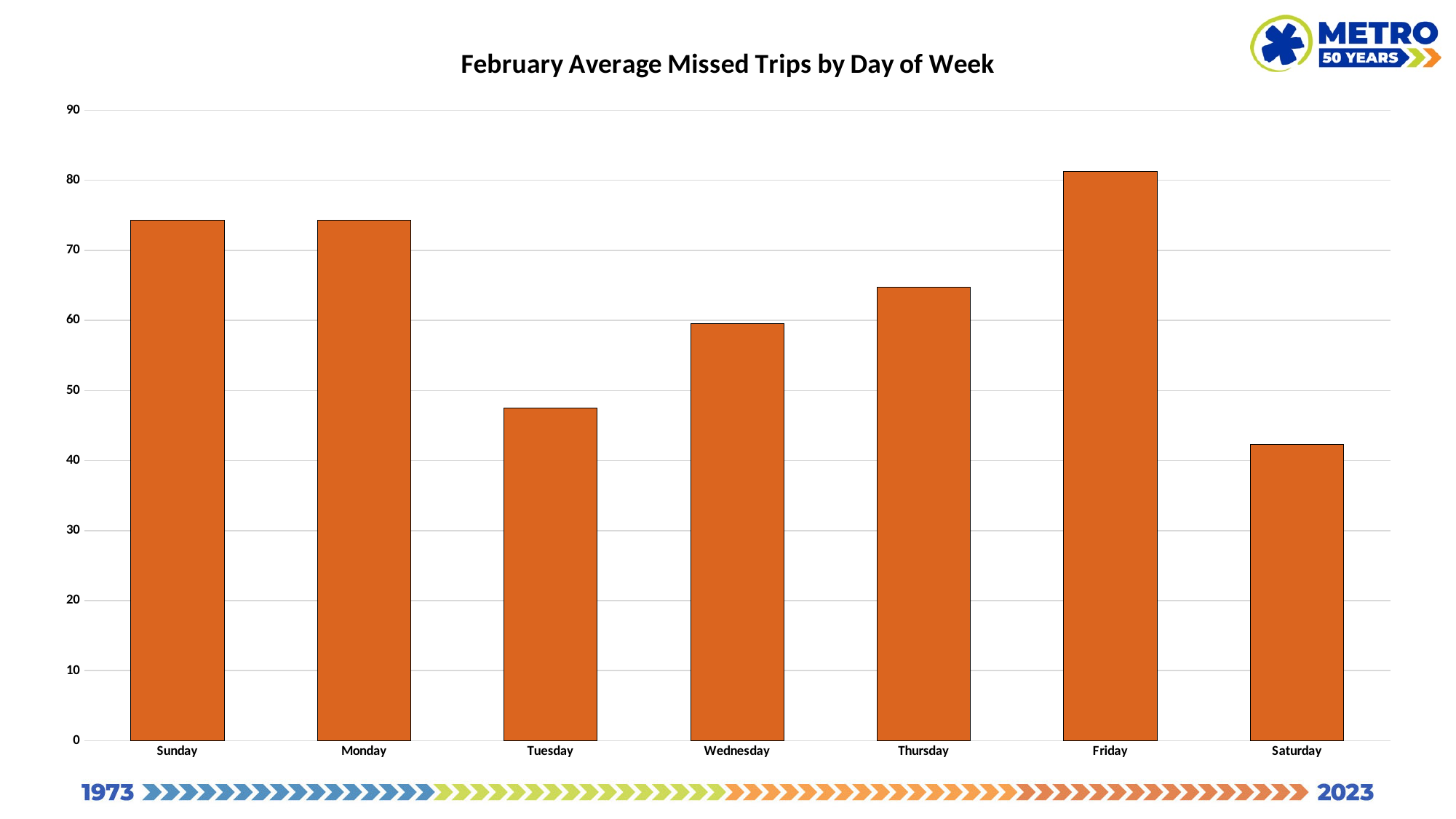
Which day of the week has the highest average missed trips? Friday Is the value for Saturday greater or less than 40? greater Do the values rise or fall from Tuesday through Friday? rise How many days of the week are plotted on the chart? 7 Is the value for Friday greater or less than 80? greater Is the value for Thursday greater or less than 60? greater Which is larger, the value for Wednesday or the value for Tuesday? Wednesday Which day of the week has the lowest average missed trips? Saturday What type of chart is shown on the slide? bar chart What is the title of the chart? February Average Missed Trips by Day of Week